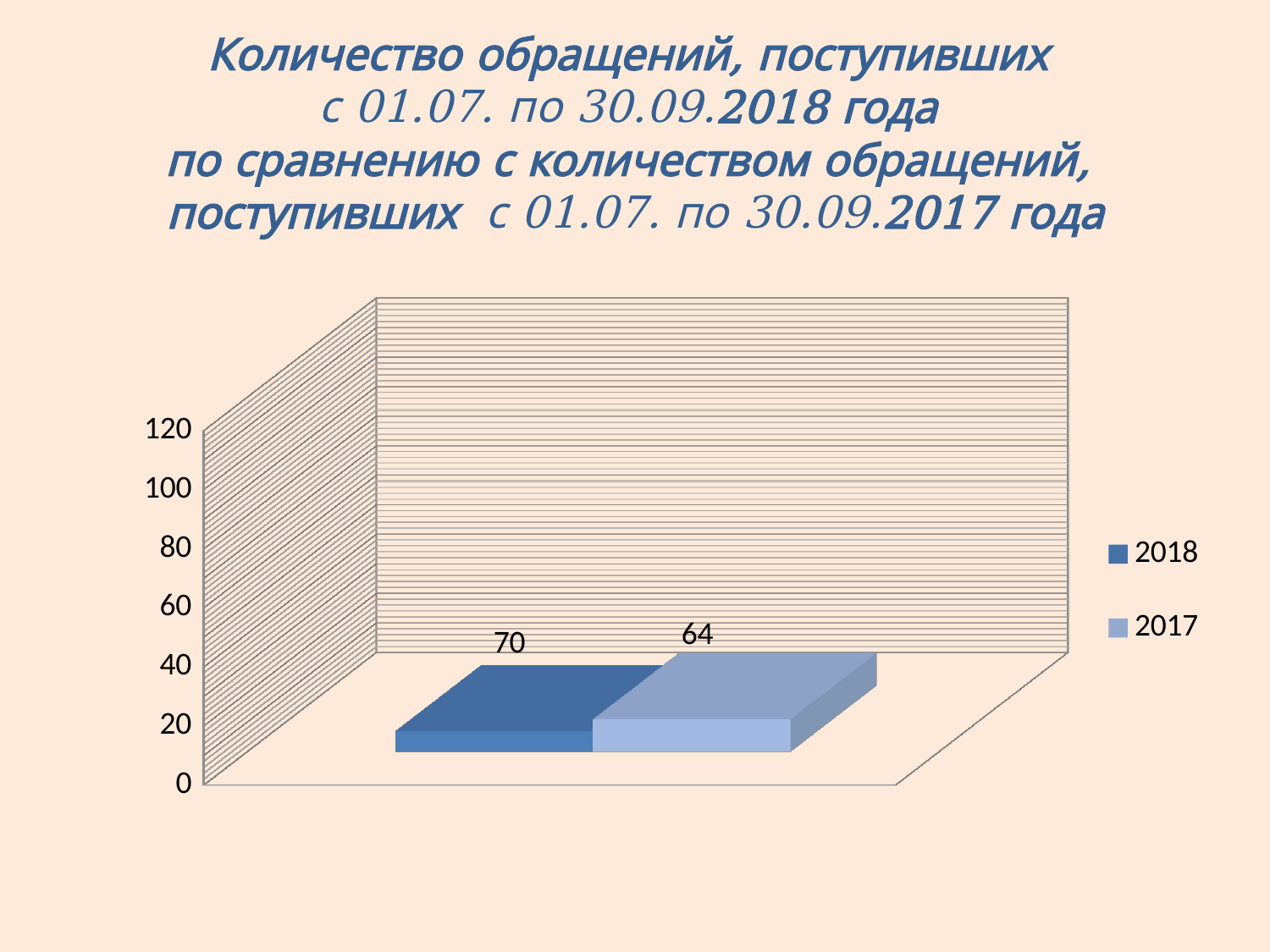
What is the value for 2017? 64 Which legend entry is shown in the darker blue colour? 2018 Which series has the higher value, 2018 or 2017? 2018 What kind of chart is shown on the slide? bar chart Is the value for 2018 greater or less than 100? less What is the value for 2018? 70 What is the highest value shown on the vertical axis? 120 Which series has the lowest value? 2017 What is the difference between the 2018 value and the 2017 value? 6 How many series does the legend list? 2